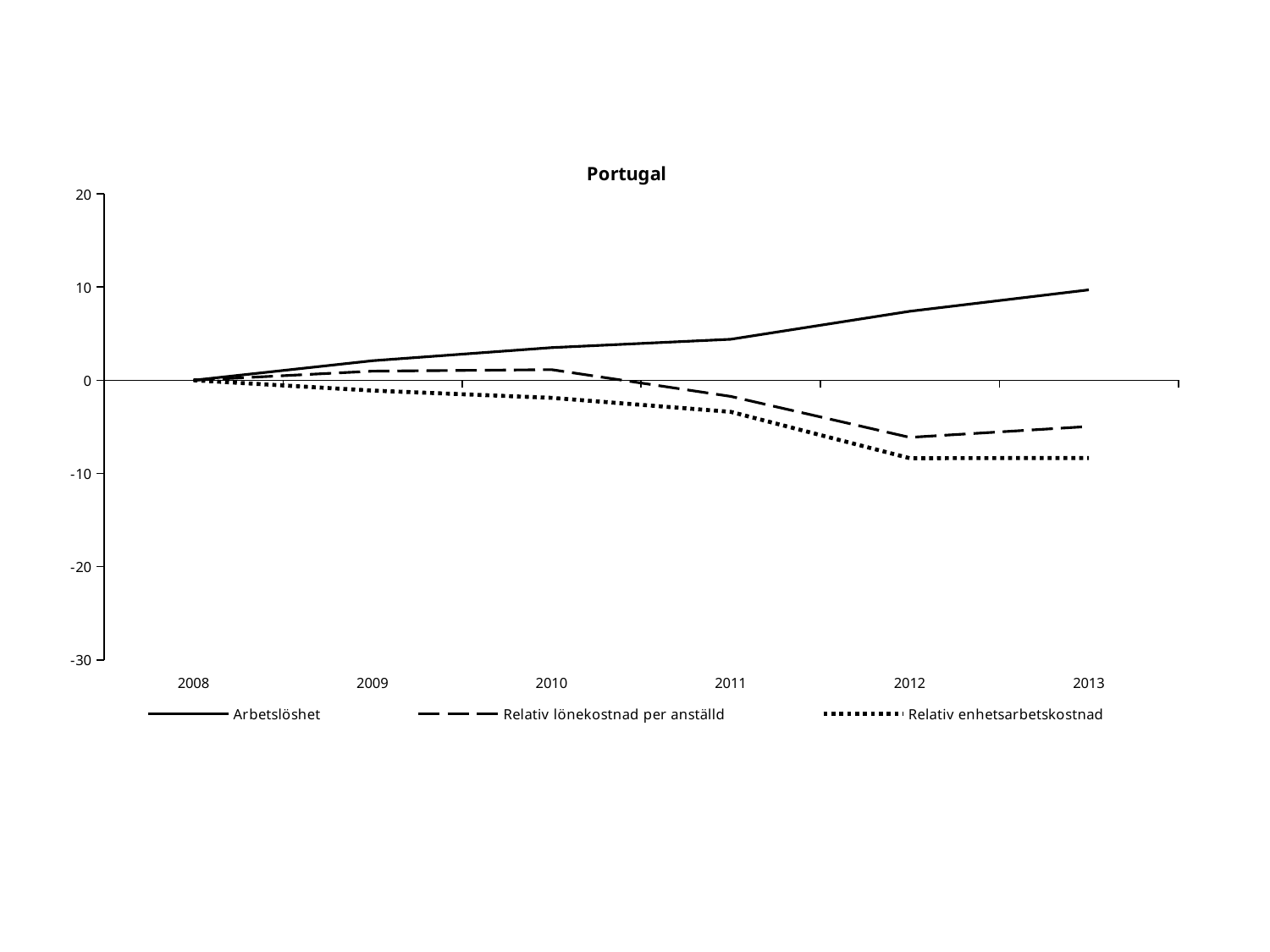
Which series has the highest value in 2013? Arbetslöshet Does the Relativ enhetsarbetskostnad line rise or fall from 2008 to 2012? Falls Does the Arbetslöshet line rise or fall from 2008 to 2013? Rises Is the value for Arbetslöshet in 2012 greater or less than 10? less How many series does the legend list? 3 Is the value for Relativ lönekostnad per anställd in 2012 greater or less than 0? less In 2012, which is larger: Relativ lönekostnad per anställd or Relativ enhetsarbetskostnad? Relativ lönekostnad per anställd Is the value for Relativ enhetsarbetskostnad in 2013 greater or less than -10? greater How many years are shown on the x axis? 6 What is the title of the chart? Portugal What kind of chart is shown on the slide? Line chart Which series has the lowest value in 2013? Relativ enhetsarbetskostnad